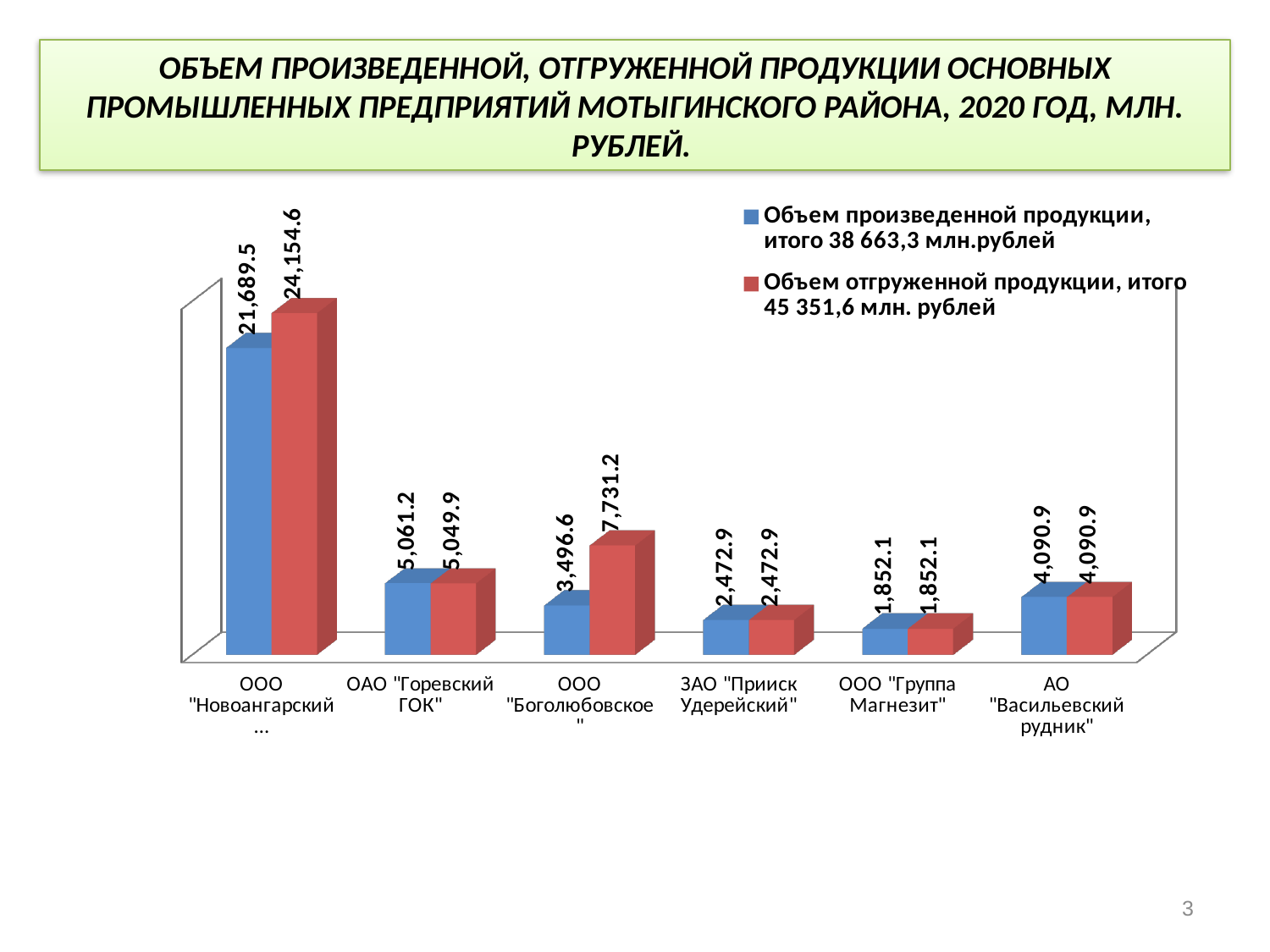
What is the value of Объем отгруженной продукции for ООО "Боголюбовское"? 7,731.2 How many categories (enterprises) are shown on the x axis? 6 What is the value of Объем произведенной продукции for ОАО "Горевский ГОК"? 5,061.2 According to the legend, what is the total Объем отгруженной продукции? 45 351,6 млн. рублей Which category has the highest value of Объем отгруженной продукции? ООО "Новоангарский…" (the leftmost category) For ООО "Боголюбовское", how much larger is Объем отгруженной продукции than Объем произведенной продукции? 4,234.6 What kind of chart is shown on the slide? Bar chart Which category has the lowest value of Объем произведенной продукции? ООО "Группа Магнезит" What is the value of Объем произведенной продукции for ЗАО "Прииск Удерейский"? 2,472.9 What is the value of Объем отгруженной продукции for ООО "Группа Магнезит"? 1,852.1 For ОАО "Горевский ГОК", which is larger: Объем произведенной продукции or Объем отгруженной продукции? Объем произведенной продукции How many series does the legend list? 2